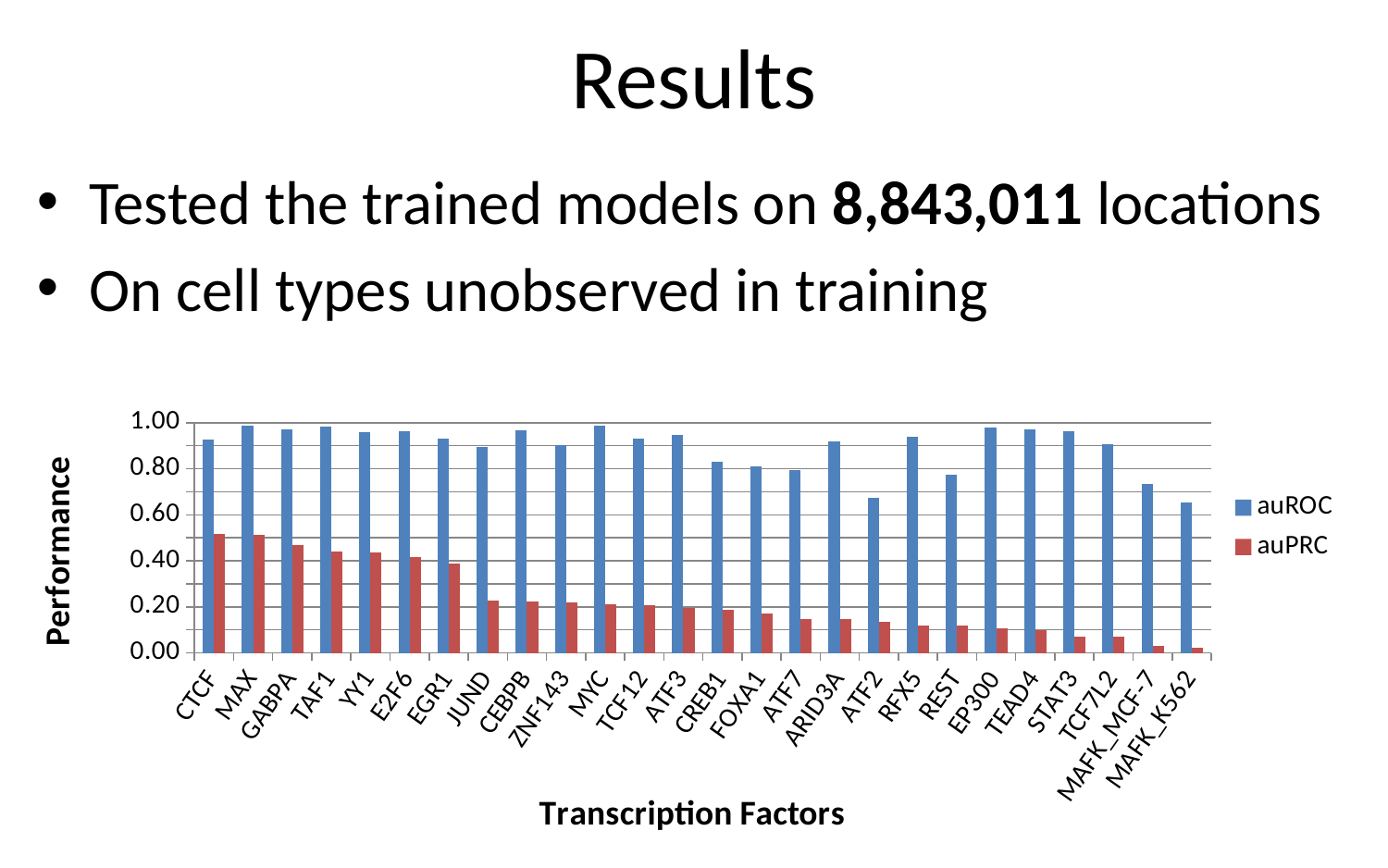
Which transcription factor has the lowest auROC value? MAFK_K562 Which transcription factor has the lowest auPRC value? MAFK_K562 How many transcription factors are shown on the x axis of the chart? 26 Which has the larger auPRC value, GABPA or ATF7? GABPA Is the auPRC value for CTCF greater or less than 0.40? greater Is the auROC value for ATF2 greater or less than 0.80? less What is the label of the y axis of the chart? Performance What kind of chart is shown on the slide? bar chart Is the auROC value for MAFK_MCF-7 greater or less than 0.80? less Do the auPRC values rise or fall moving left to right along the x axis? fall Which is larger for GABPA: the auROC value or the auPRC value? auROC How many series does the chart legend list? 2